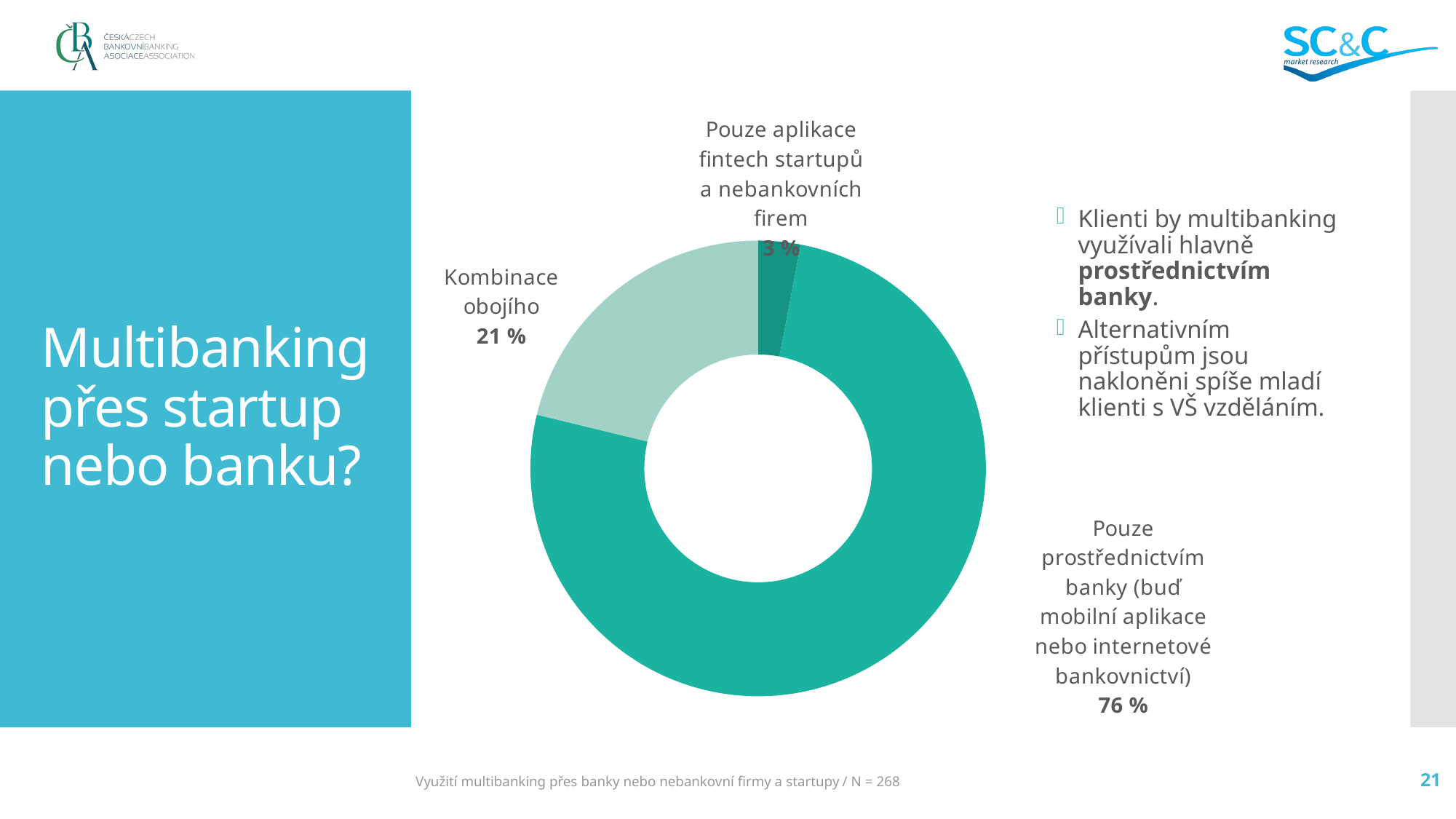
What share of the chart is 'Pouze aplikace fintech startupů a nebankovních firem'? 3 % Which is larger: the share for 'Kombinace obojího' or the share for 'Pouze aplikace fintech startupů a nebankovních firem'? Kombinace obojího What kind of chart is shown on the slide? Doughnut (pie) chart What share of the chart is 'Kombinace obojího'? 21 % What share of the chart is 'Pouze prostřednictvím banky (buď mobilní aplikace nebo internetové bankovnictví)'? 76 % What is the difference in percentage points between 'Pouze prostřednictvím banky' and 'Kombinace obojího'? 55 percentage points What is the sample size (N) stated in the chart's footnote? 268 How many categories are shown in the chart? 3 Which category has the largest share in the chart? Pouze prostřednictvím banky (buď mobilní aplikace nebo internetové bankovnictví) Which category has the smallest share in the chart? Pouze aplikace fintech startupů a nebankovních firem What is the title of the slide? Multibanking přes startup nebo banku? What is the difference in percentage points between 'Kombinace obojího' and 'Pouze aplikace fintech startupů a nebankovních firem'? 18 percentage points